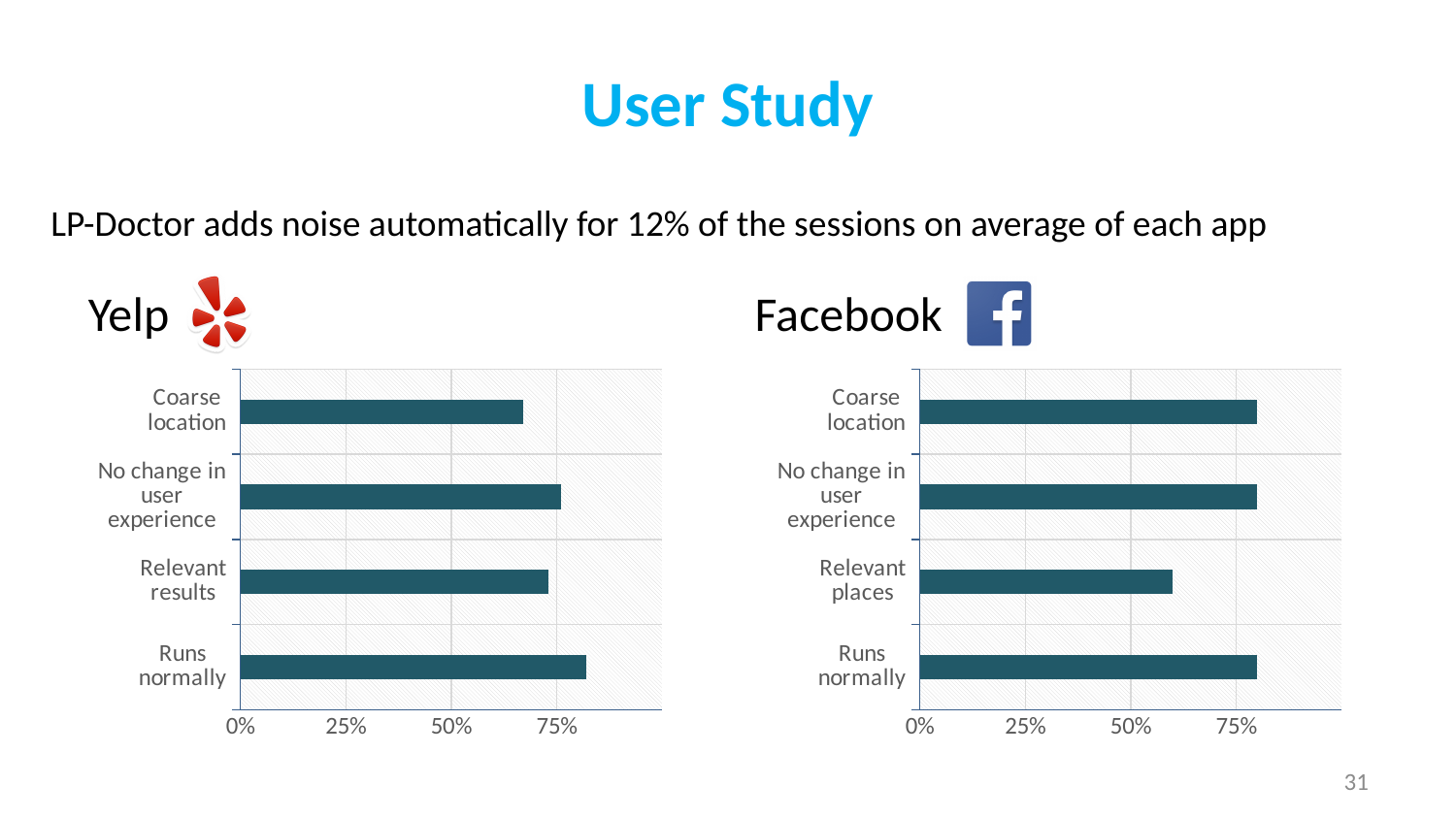
In the Yelp chart, which is larger: Runs normally or Relevant results? Runs normally In the Facebook chart, is the value for Relevant places greater or less than 75%? less In the Yelp chart, is the value for Runs normally greater or less than 75%? greater What is the title of the slide containing the two charts? User Study How many categories does the Facebook chart show? 4 In the Yelp chart, is the value for Coarse location greater or less than 75%? less In the Yelp chart, which category has the highest value? Runs normally In the Yelp chart, which category has the lowest value? Coarse location In the Facebook chart, which category has the lowest value? Relevant places In the Facebook chart, which is larger: Coarse location or Relevant places? Coarse location What type of chart is the Yelp chart? bar chart